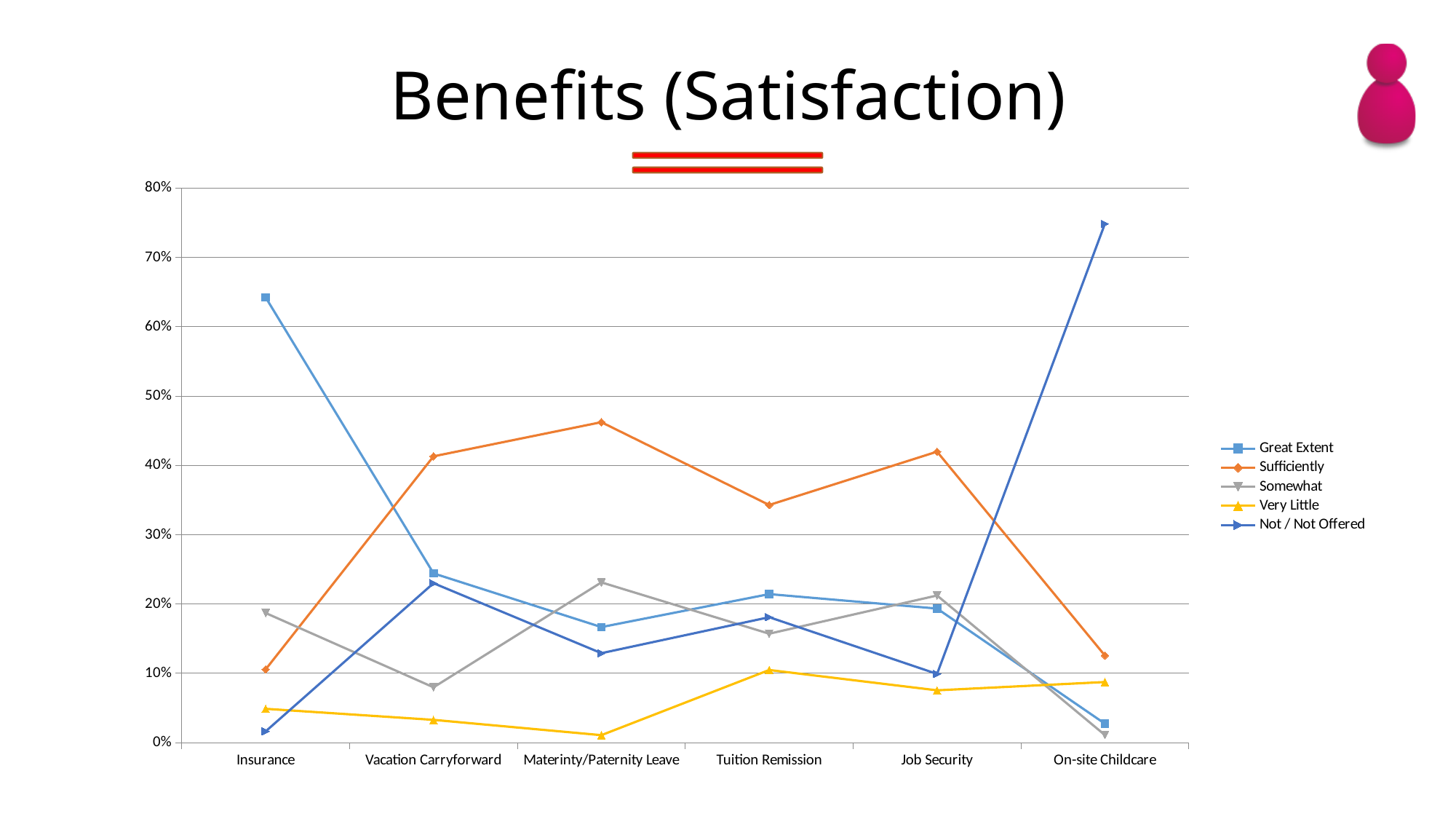
For Vacation Carryforward, which is larger: Sufficiently or Great Extent? Sufficiently Does the Great Extent series rise or fall from Insurance to Vacation Carryforward? fall For which benefit is the Great Extent series highest? Insurance Is the Great Extent value for Insurance greater or less than 60%? greater How many series does the legend list? 5 Is the Not / Not Offered value for On-site Childcare greater or less than 70%? greater What kind of chart is shown on the slide? line chart How many benefit categories are shown on the x axis? 6 What is the title of the chart? Benefits (Satisfaction) Is the Sufficiently value for Materinty/Paternity Leave greater or less than 40%? greater For which benefit is the Not / Not Offered series highest? On-site Childcare For which benefit is the Great Extent series lowest? On-site Childcare